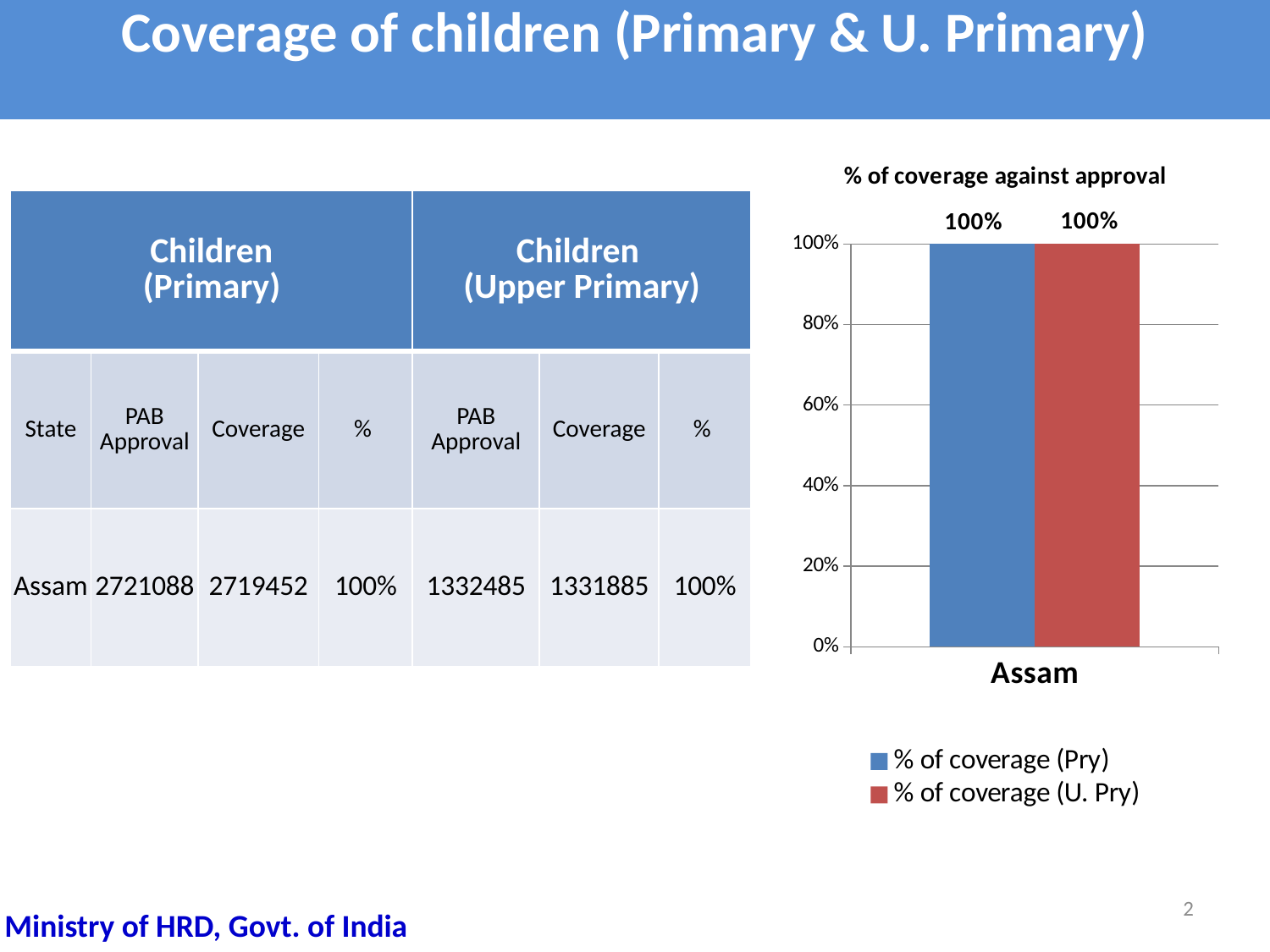
What is the title of the chart? % of coverage against approval How many categories are shown on the x axis of the chart? 1 What is the difference between % of coverage (Pry) and % of coverage (U. Pry) for Assam? 0% Is the value for % of coverage (Pry) for Assam greater or less than 80%? greater What is the value of % of coverage (U. Pry) for Assam? 100% What kind of chart is shown on the slide? bar chart What is the value of % of coverage (Pry) for Assam? 100% Which state is shown on the x axis of the chart? Assam Which series is shown in red in the chart? % of coverage (U. Pry) How many series does the chart legend list? 2 Is the value for % of coverage (U. Pry) for Assam greater or less than 60%? greater